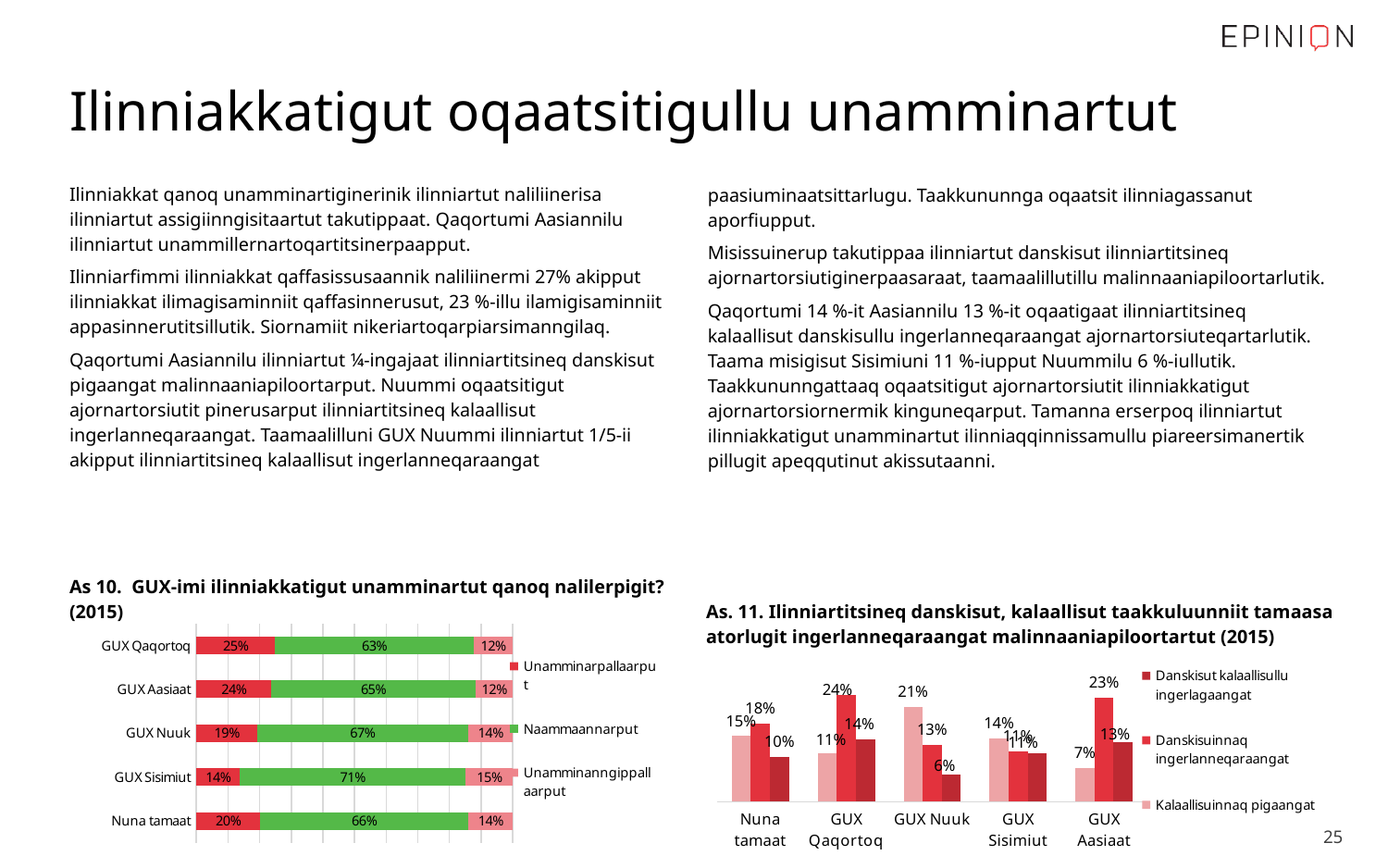
How many series does the legend of chart As 10 list? 3 How many categories are shown in chart As 10? 5 In chart As. 11, which category has the highest Danskisuinnaq ingerlanneqaraangat value? GUX Qaqortoq In chart As 10, which category has the highest Naammaannarput share? GUX Sisimiut In chart As. 11, which category has the lowest Danskisut kalaallisullu ingerlagaangat value? GUX Nuuk In chart As. 11, for Nuna tamaat, which is larger: Danskisuinnaq ingerlanneqaraangat or Kalaallisuinnaq pigaangat? Danskisuinnaq ingerlanneqaraangat In chart As 10, what is the Naammaannarput value for GUX Sisimiut? 71% In chart As. 11, what is the Kalaallisuinnaq pigaangat value for GUX Nuuk? 21% What kind of chart is 'As 10. GUX-imi ilinniakkatigut unamminartut qanoq nalilerpigit? (2015)'? Stacked bar chart What kind of chart is 'As. 11. Ilinniartitsineq danskisut, kalaallisut taakkuluunniit tamaasa atorlugit ingerlanneqaraangat malinnaaniapiloortartut (2015)'? Bar chart In chart As 10, what is the Unamminarpallaarput value for GUX Qaqortoq? 25% In chart As 10, what is the difference between the Unamminarpallaarput values for GUX Qaqortoq and GUX Sisimiut? 11 percentage points